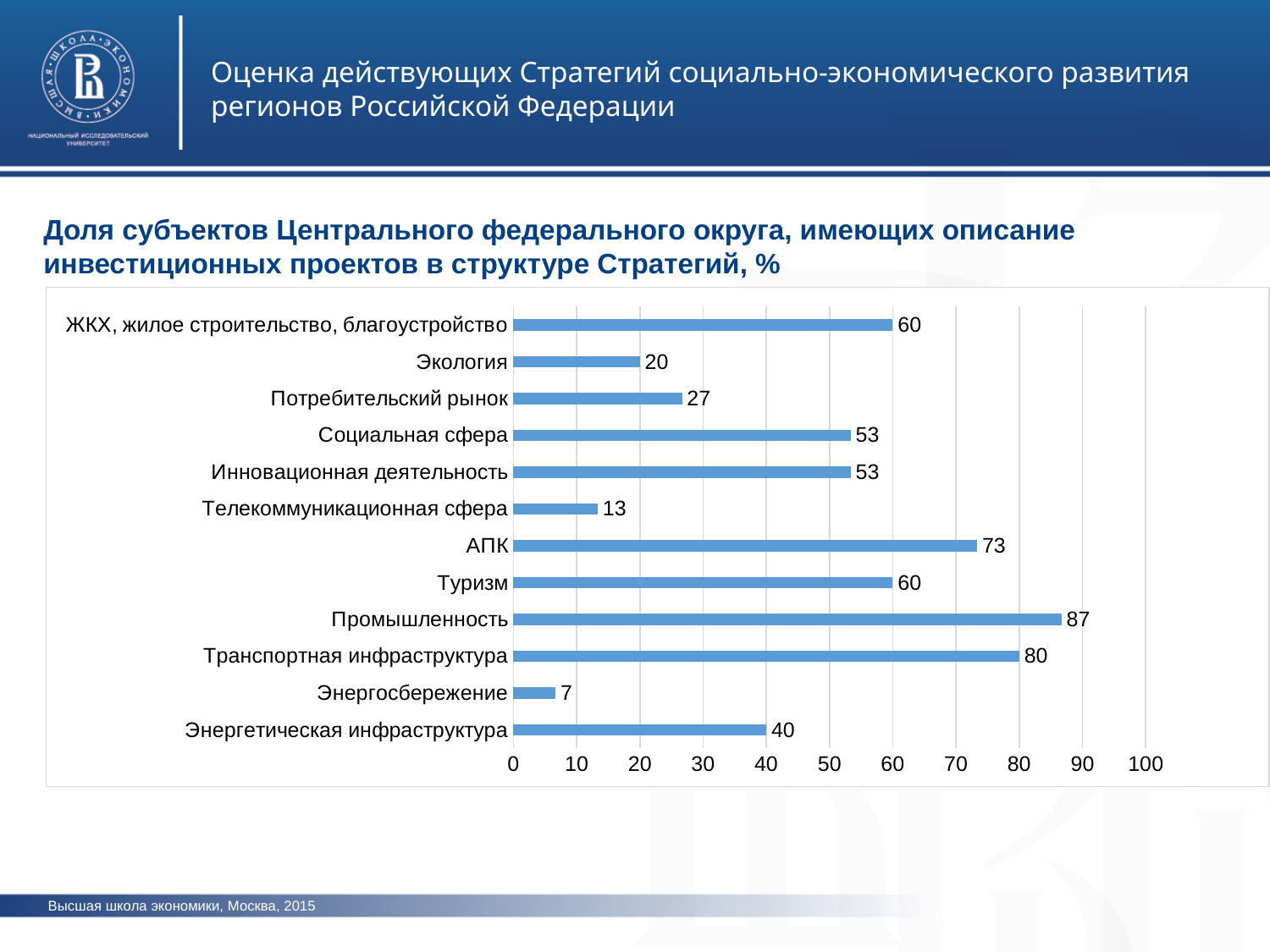
Which category has the lowest value? Энергосбережение What is the value for Энергосбережение? 7 What is the value for АПК? 73 What is the maximum value shown on the horizontal axis? 100 Is the value for Энергетическая инфраструктура greater or less than 50? less What is the difference between the values for Промышленность and Транспортная инфраструктура? 7 What kind of chart is shown on the slide? bar chart What is the value for Промышленность? 87 Which is larger, the value for Экология or the value for Потребительский рынок? Потребительский рынок What is the value for Телекоммуникационная сфера? 13 Which category has the highest value? Промышленность How many categories are shown in the chart? 12